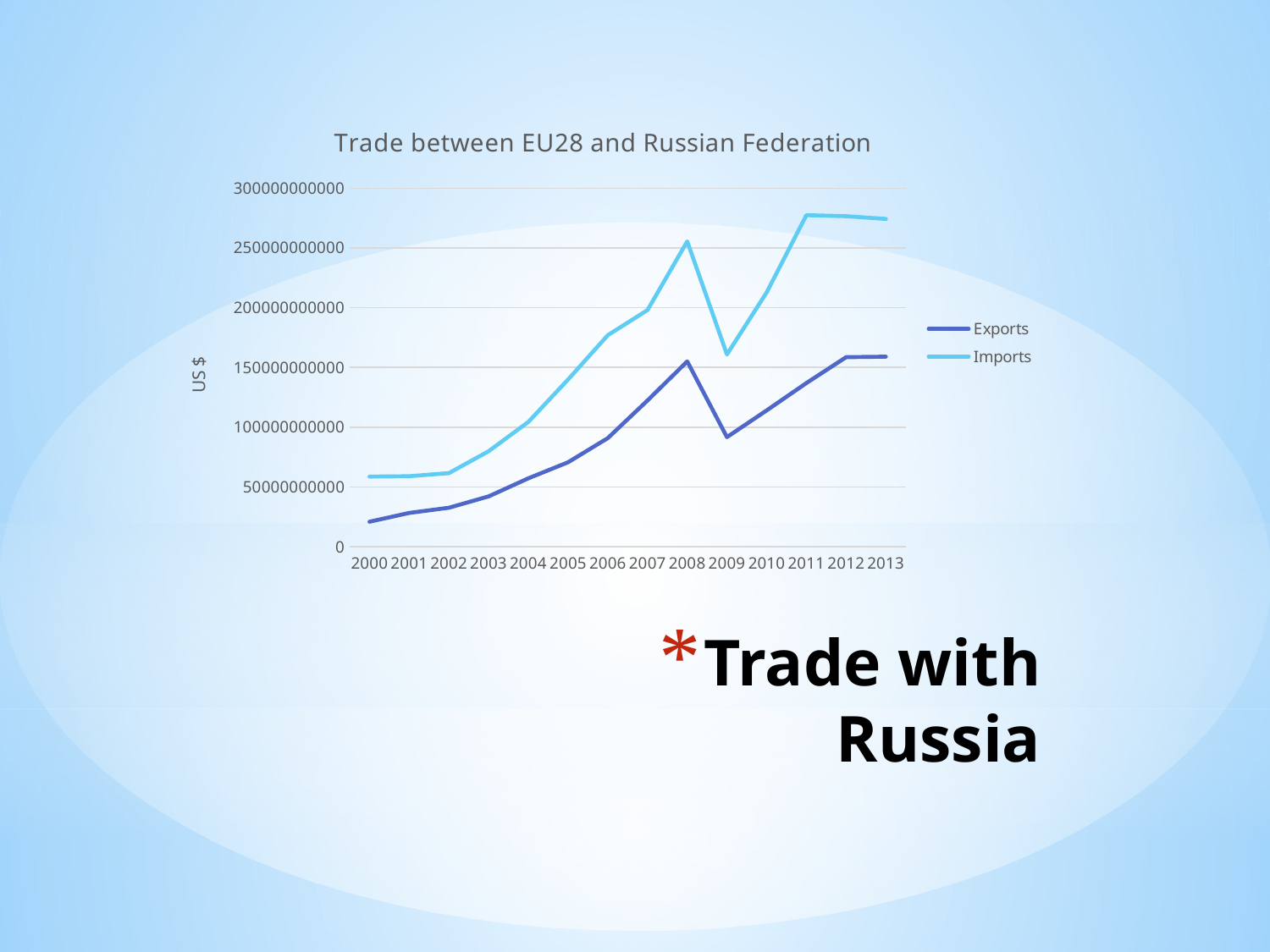
What is the title of the chart? Trade between EU28 and Russian Federation How many series does the legend list? 2 What kind of chart is shown on the slide? Line chart Is the Exports value for 2005 greater or less than 50000000000? greater Overall, do the Imports values rise or fall from 2000 to 2013? Rise Is the Imports value for 2011 greater or less than 250000000000? greater How many years are shown on the x axis? 14 Is the Exports value for 2000 greater or less than 50000000000? less In which year is the Exports value lowest? 2000 For Exports, which year has the larger value, 2008 or 2009? 2008 In 2008, which is larger, Exports or Imports? Imports